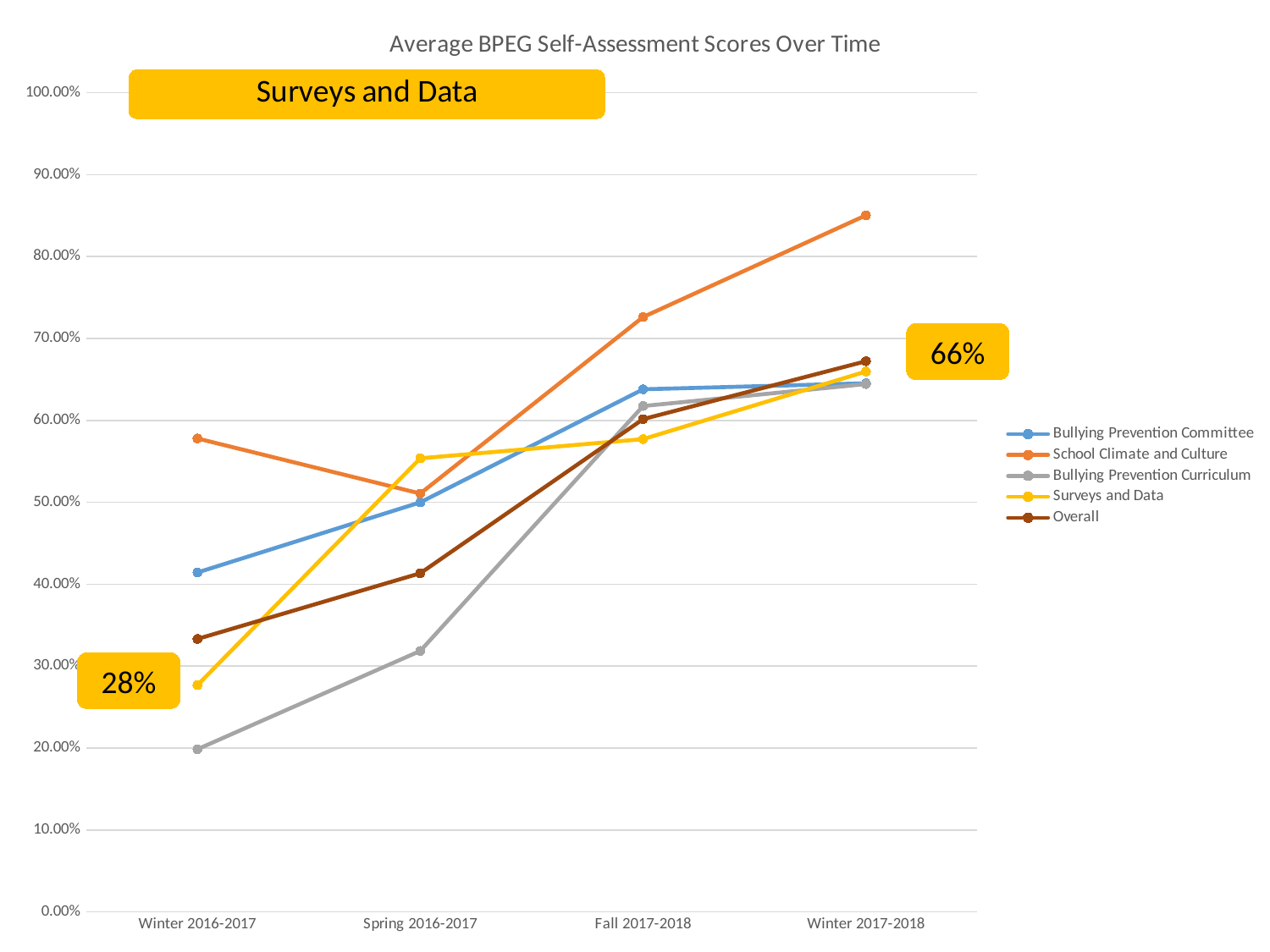
Is the value for Bullying Prevention Curriculum in Winter 2016-2017 greater or less than 30.00%? less Does the School Climate and Culture series rise or fall from Winter 2016-2017 to Spring 2016-2017? Fall Is the value for School Climate and Culture in Winter 2017-2018 greater or less than 80.00%? greater Which series has the highest value in Winter 2017-2018? School Climate and Culture How many series does the legend list? 5 Which series has the lowest value in Winter 2016-2017? Bullying Prevention Curriculum How many time periods are shown on the x axis? 4 Is the value for Surveys and Data in Fall 2017-2018 greater or less than 60.00%? less Does the Overall series rise or fall from Winter 2016-2017 to Winter 2017-2018? Rise What kind of chart is shown on the slide? Line chart In Winter 2016-2017, which is higher: School Climate and Culture or Bullying Prevention Committee? School Climate and Culture What is the title of the chart? Average BPEG Self-Assessment Scores Over Time